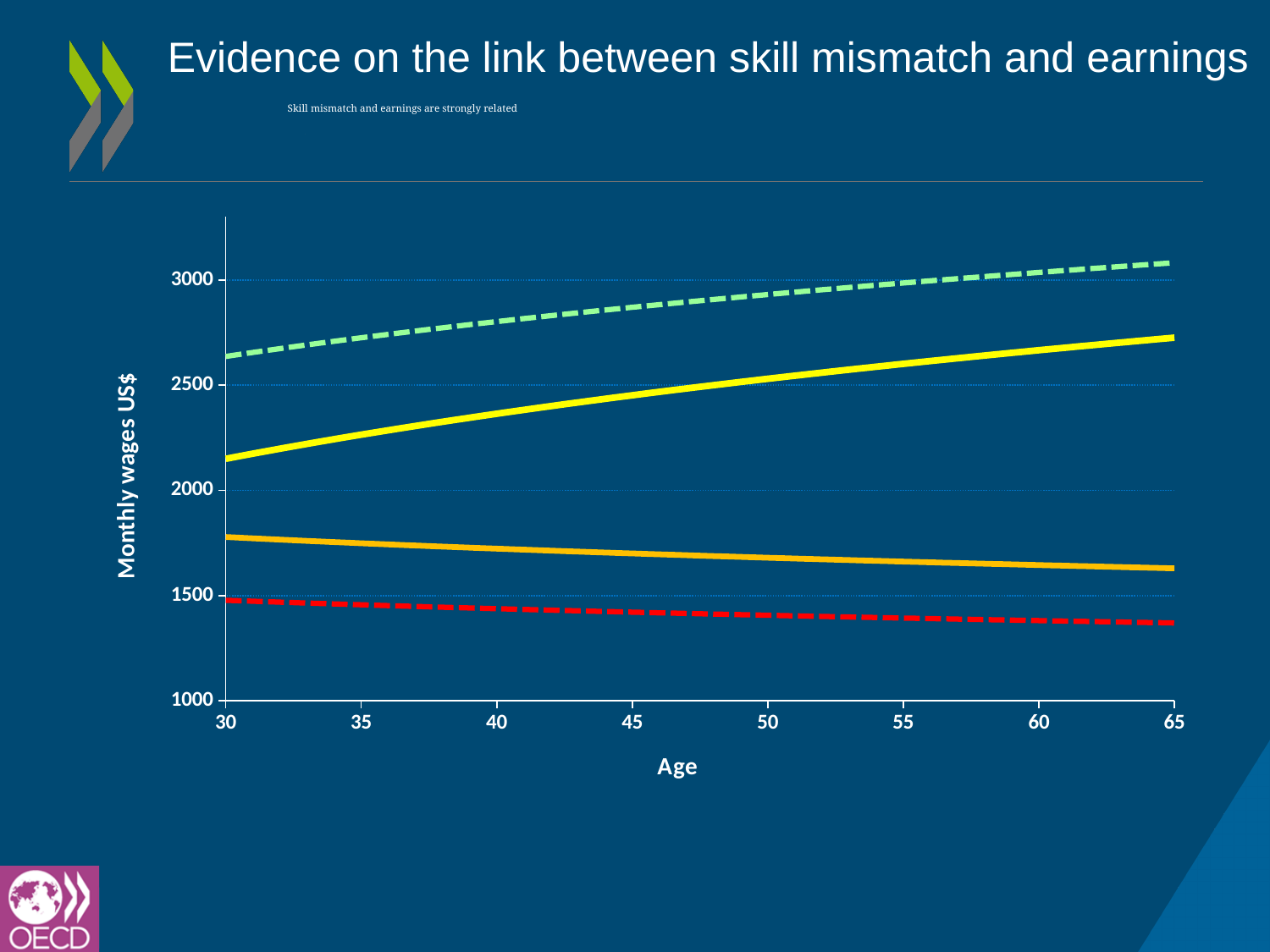
Does the red dashed line rise or fall as age increases from 30 to 65? fall What is the label of the horizontal axis? Age Does the solid orange line rise or fall as age increases from 30 to 65? fall Is the value of the green dashed line at age 65 greater or less than 3000? greater Does the green dashed line rise or fall as age increases from 30 to 65? rise What is the label of the vertical axis? Monthly wages US$ How many lines are plotted on the chart? 4 What kind of chart is shown on the slide? line chart Is the value of the solid yellow line at age 30 greater or less than 2000? greater At age 50, which line has the higher value: the solid yellow line or the solid orange line? the solid yellow line